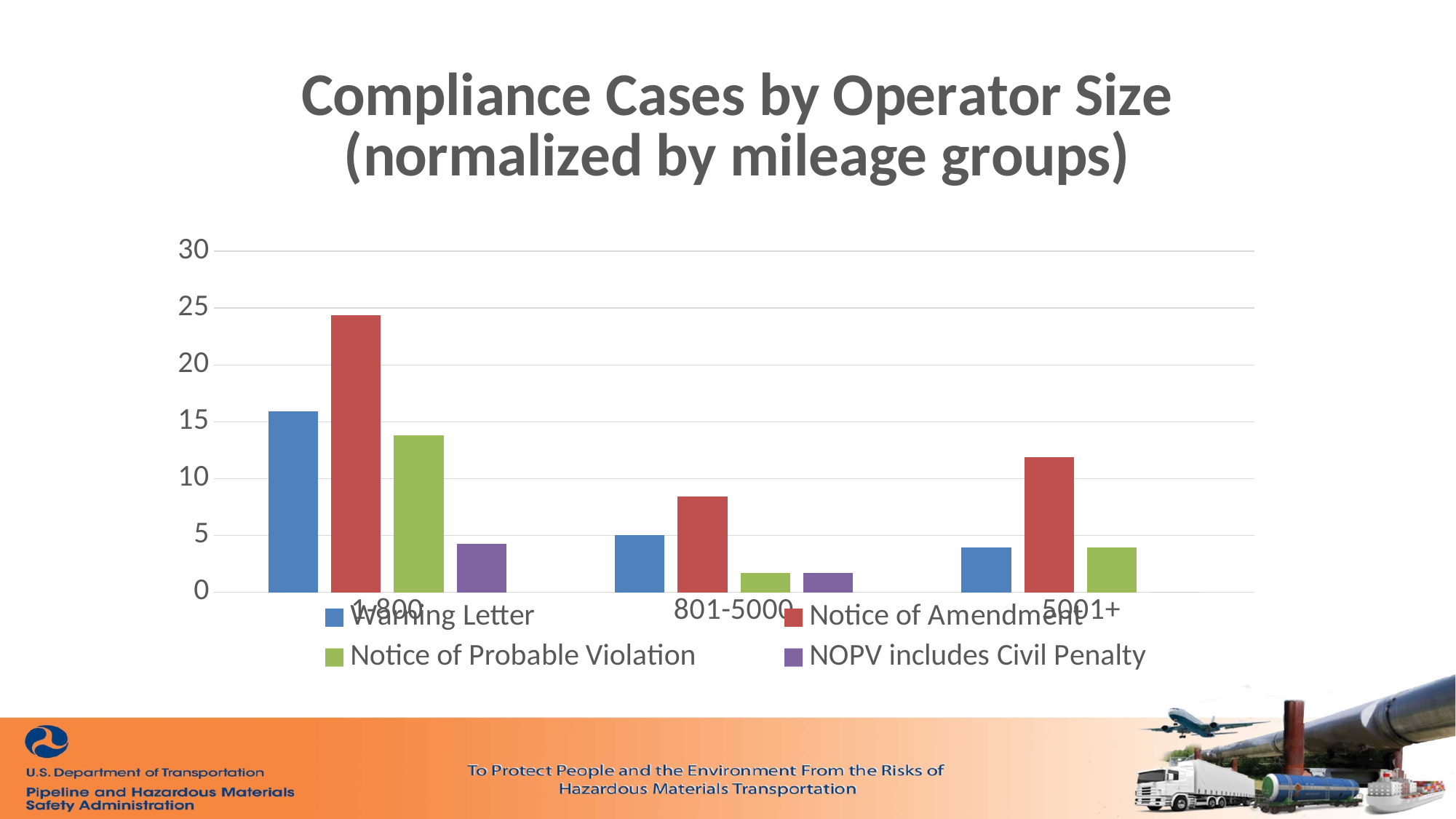
Is the Notice of Amendment value for 801-5000 greater or less than 10? less Is the Notice of Amendment value for 1-800 greater or less than 20? greater What kind of chart is shown on the slide? bar chart Is the Notice of Amendment value for 5001+ greater or less than 10? greater In which operator size category is the Notice of Amendment value highest? 1-800 Which series has the highest value in the 1-800 category? Notice of Amendment How many operator size categories are shown on the x axis? 3 Which series has the lowest value in the 1-800 category? NOPV includes Civil Penalty Which is larger: the Warning Letter value for 1-800 or for 801-5000? 1-800 How many series does the legend list? 4 Does the Warning Letter value rise or fall from 1-800 to 5001+? fall